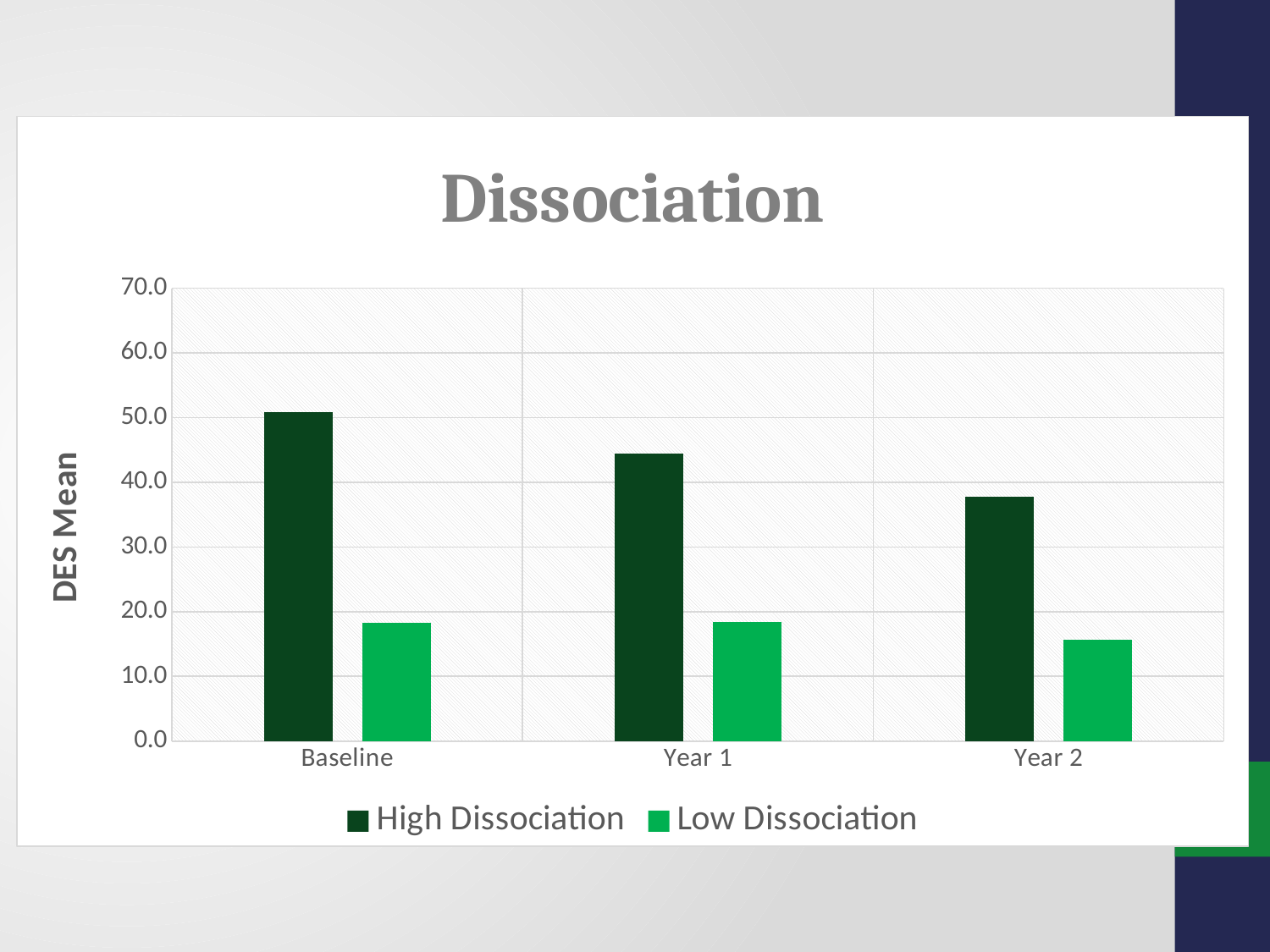
At Year 1, which is larger: High Dissociation or Low Dissociation? High Dissociation What is the label on the y axis? DES Mean Is the Low Dissociation value for Year 1 greater or less than 20? less How many categories are shown on the x axis? 3 What kind of chart is shown on the slide? bar chart Which category has the lowest Low Dissociation value? Year 2 Do the High Dissociation values rise or fall from Baseline to Year 2? fall Which category has the lowest High Dissociation value? Year 2 Is the High Dissociation value for Year 2 greater or less than 40? less How many series does the legend list? 2 Which category has the highest High Dissociation value? Baseline